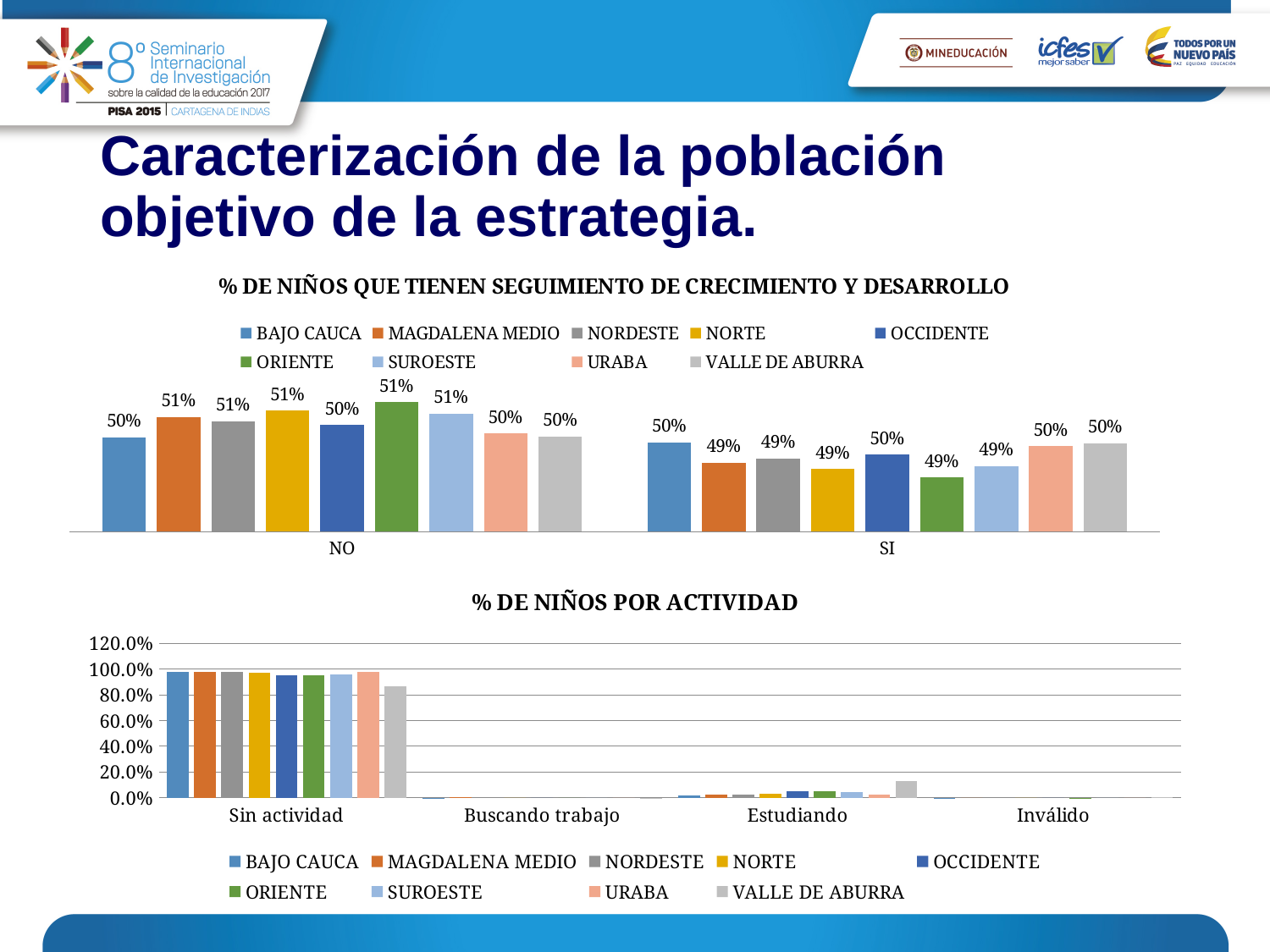
In the chart '% DE NIÑOS POR ACTIVIDAD', how many categories are shown on the x axis? 4 In the chart '% DE NIÑOS POR ACTIVIDAD', which category has the highest values across the series? Sin actividad What kind of chart is '% DE NIÑOS POR ACTIVIDAD'? Bar chart In the chart '% DE NIÑOS QUE TIENEN SEGUIMIENTO DE CRECIMIENTO Y DESARROLLO', how many categories are shown on the x axis? 2 In the chart '% DE NIÑOS QUE TIENEN SEGUIMIENTO DE CRECIMIENTO Y DESARROLLO', what is the difference between the NO and SI values for NORTE? 2% In the chart '% DE NIÑOS QUE TIENEN SEGUIMIENTO DE CRECIMIENTO Y DESARROLLO', what is the value for VALLE DE ABURRA in the SI category? 50% In the chart '% DE NIÑOS QUE TIENEN SEGUIMIENTO DE CRECIMIENTO Y DESARROLLO', how many series does the legend list? 9 In the chart '% DE NIÑOS POR ACTIVIDAD', which series is shown in orange? MAGDALENA MEDIO In the chart '% DE NIÑOS POR ACTIVIDAD', is the value for VALLE DE ABURRA in 'Sin actividad' greater or less than 80.0%? greater In the chart '% DE NIÑOS POR ACTIVIDAD', is the value for VALLE DE ABURRA in 'Estudiando' greater or less than 20.0%? less In the chart '% DE NIÑOS QUE TIENEN SEGUIMIENTO DE CRECIMIENTO Y DESARROLLO', what is the value for MAGDALENA MEDIO in the NO category? 51% In the chart '% DE NIÑOS QUE TIENEN SEGUIMIENTO DE CRECIMIENTO Y DESARROLLO', what is the value for ORIENTE in the SI category? 49%